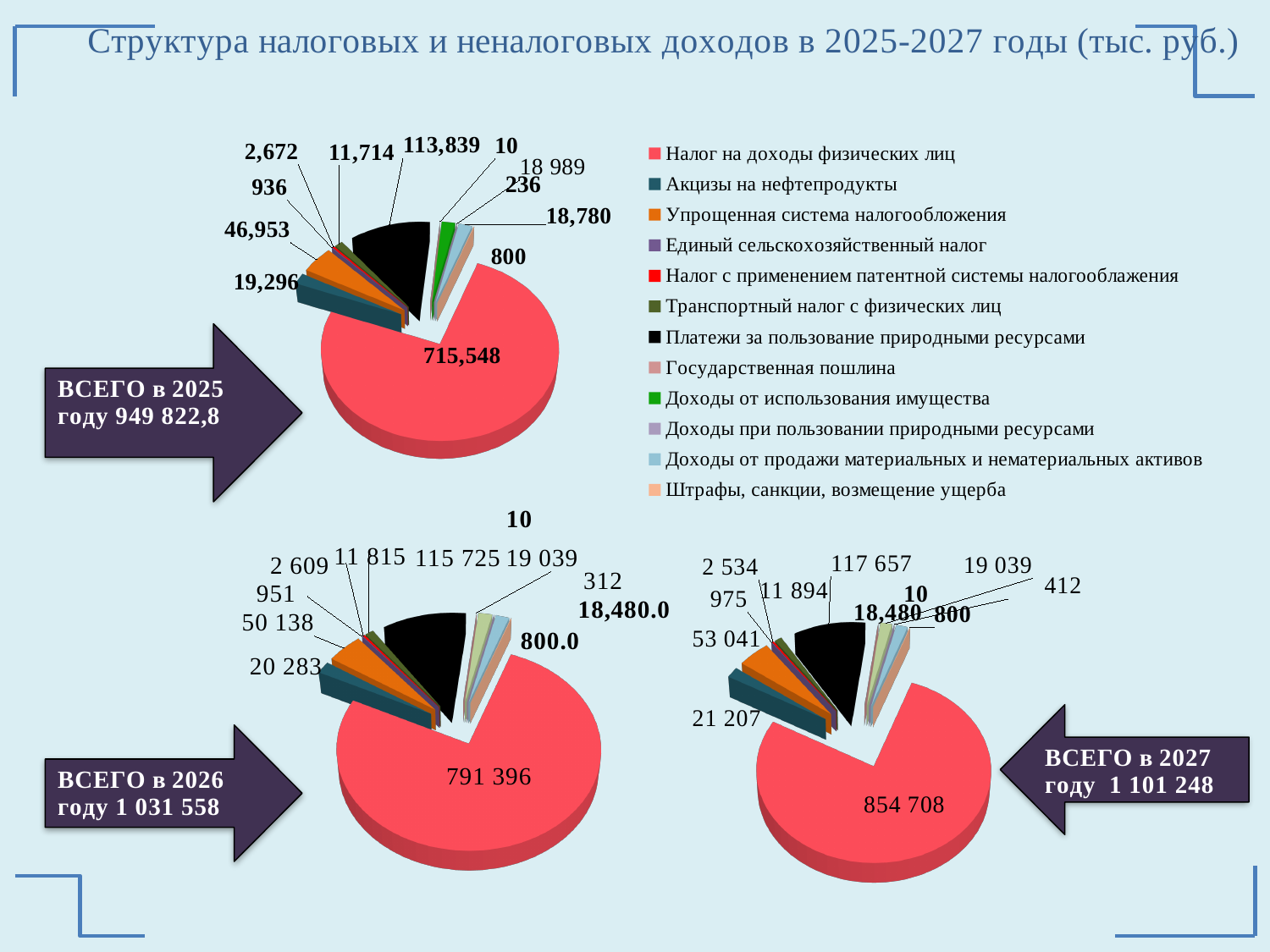
How many entries does the legend list? 12 In the 2027 pie chart, what is the value of the largest slice (Налог на доходы физических лиц)? 854 708 In the 2025 pie chart, what is the value of the largest slice (Налог на доходы физических лиц)? 715,548 What is the difference between the largest slice in the 2027 pie chart (854 708) and the largest slice in the 2026 pie chart (791 396)? 63 312 In the 2025 pie chart, what is the value of the black slice (Платежи за пользование природными ресурсами)? 113,839 In the 2026 pie chart, what is the value of the largest slice (Налог на доходы физических лиц)? 791 396 Which category has the largest slice in the 2026 pie chart? Налог на доходы физических лиц In the 2027 pie chart, what is the value of the black slice (Платежи за пользование природными ресурсами)? 117 657 Which is larger: the black slice in the 2026 pie chart (115 725) or the black slice in the 2025 pie chart (113,839)? 2026 (115 725) What is the title of the slide? Структура налоговых и неналоговых доходов в 2025-2027 годы (тыс. руб.) What total is given for 2027 in the arrow next to the 2027 pie chart? 1 101 248 What type of charts are shown on the slide? Pie charts